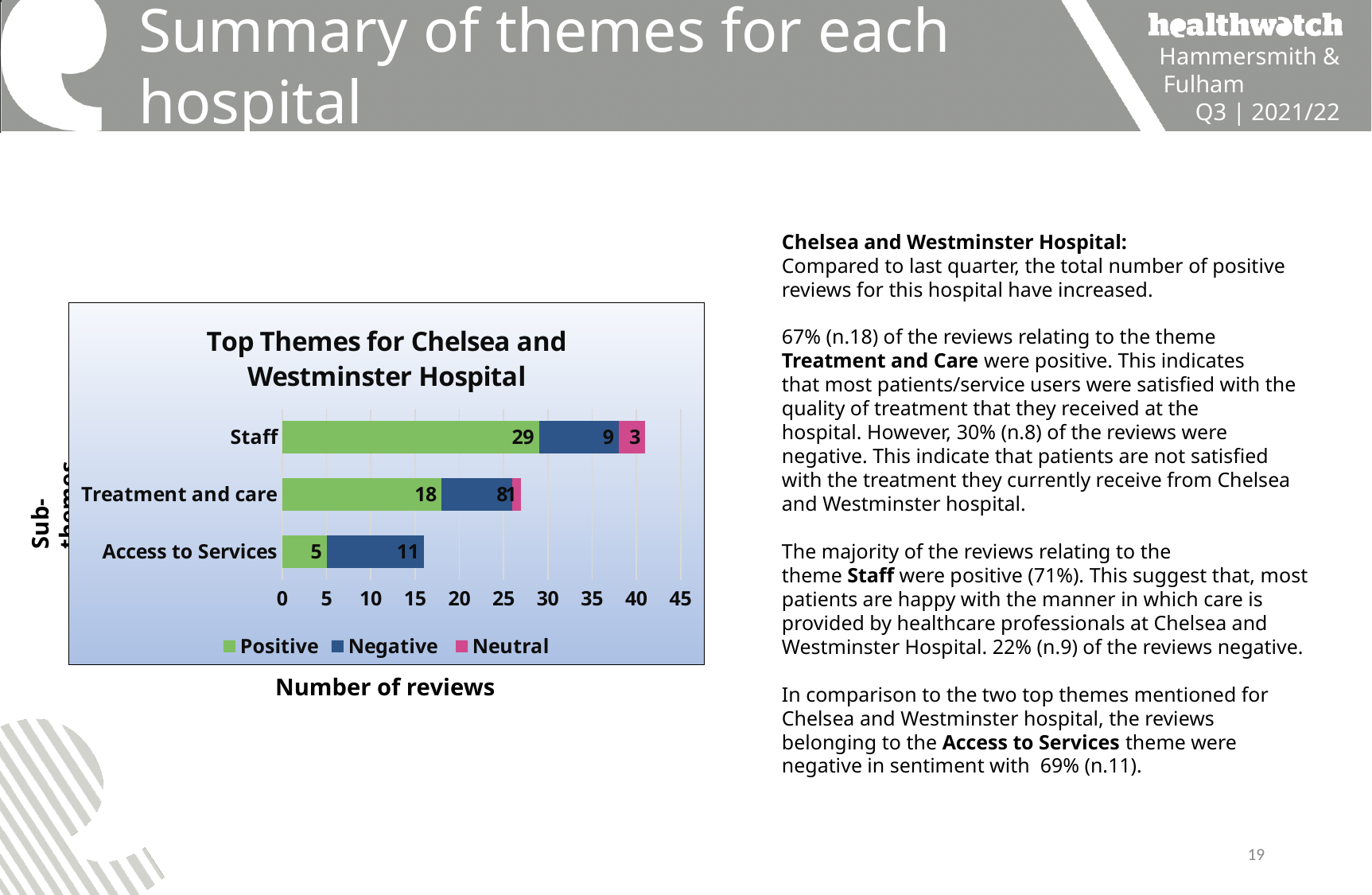
What is the total number of reviews in the Staff bar? 41 How many neutral reviews are shown for the Staff theme? 3 How many positive reviews are shown for the Staff theme? 29 What kind of chart is shown on the slide? Stacked bar chart What is the difference between the positive reviews for Staff and for Treatment and care? 11 How many themes (categories) are plotted on the chart? 3 Which theme has the lowest number of positive reviews? Access to Services How many series does the legend of the chart list? 3 Which theme has the highest number of positive reviews? Staff For Access to Services, are there more positive or negative reviews? Negative How many positive reviews are shown for the Treatment and care theme? 18 How many negative reviews are shown for the Access to Services theme? 11